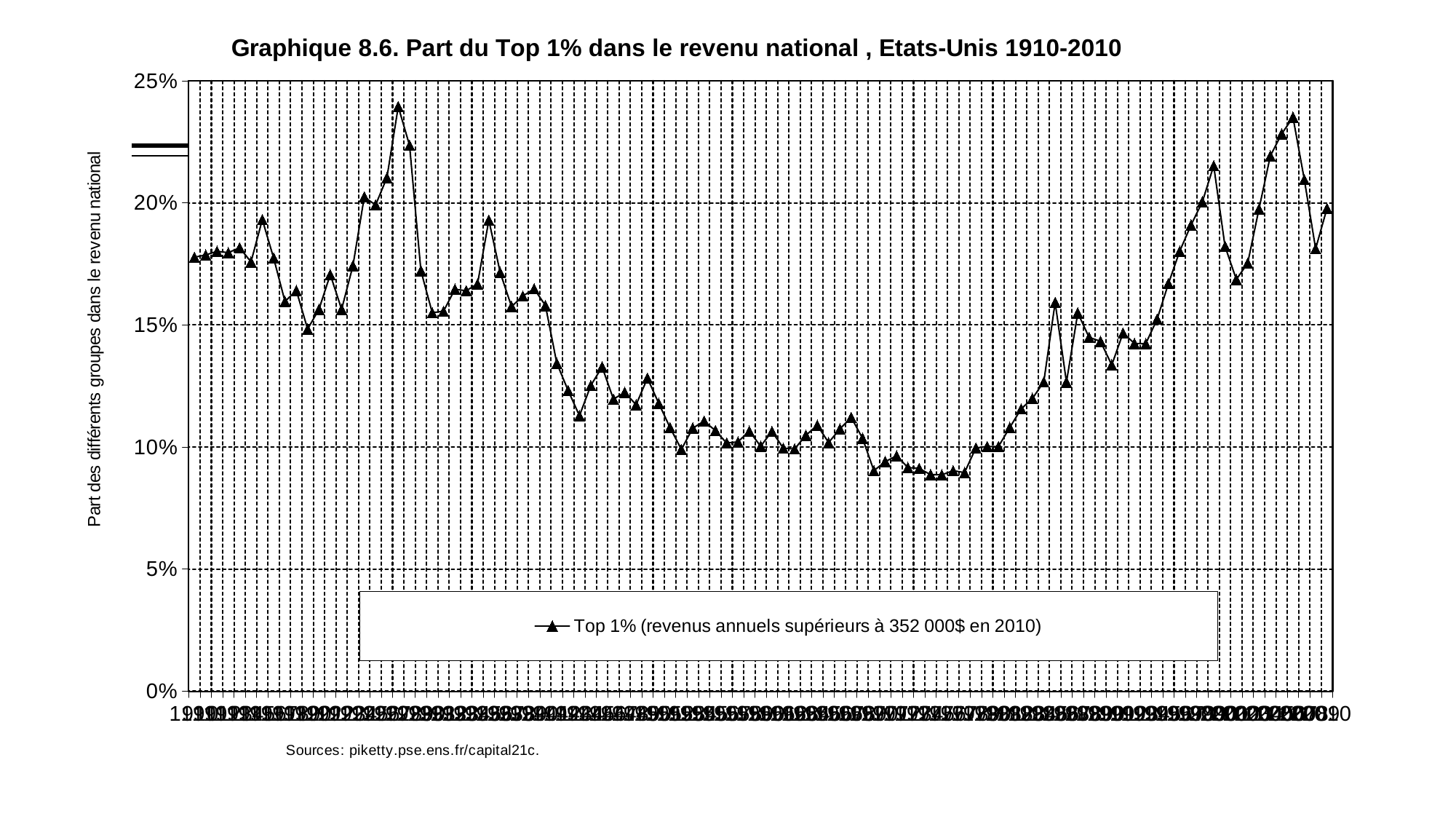
Is the highest value reached by the series greater or less than 20%? greater Does the series end (at the right of the x axis) above or below 15%? above What is the title of the chart? Graphique 8.6. Part du Top 1% dans le revenu national , Etats-Unis 1910-2010 What is the maximum value shown on the y axis? 25% Is the lowest value reached by the series greater or less than 5%? greater How many series does the legend list? 1 What is the legend entry for the plotted series? Top 1% (revenus annuels supérieurs à 352 000$ en 2010) Over the middle of the period, do the values fall to a low and then rise again, or rise to a high and then fall? fall to a low and then rise again What kind of chart is shown on the slide? line chart